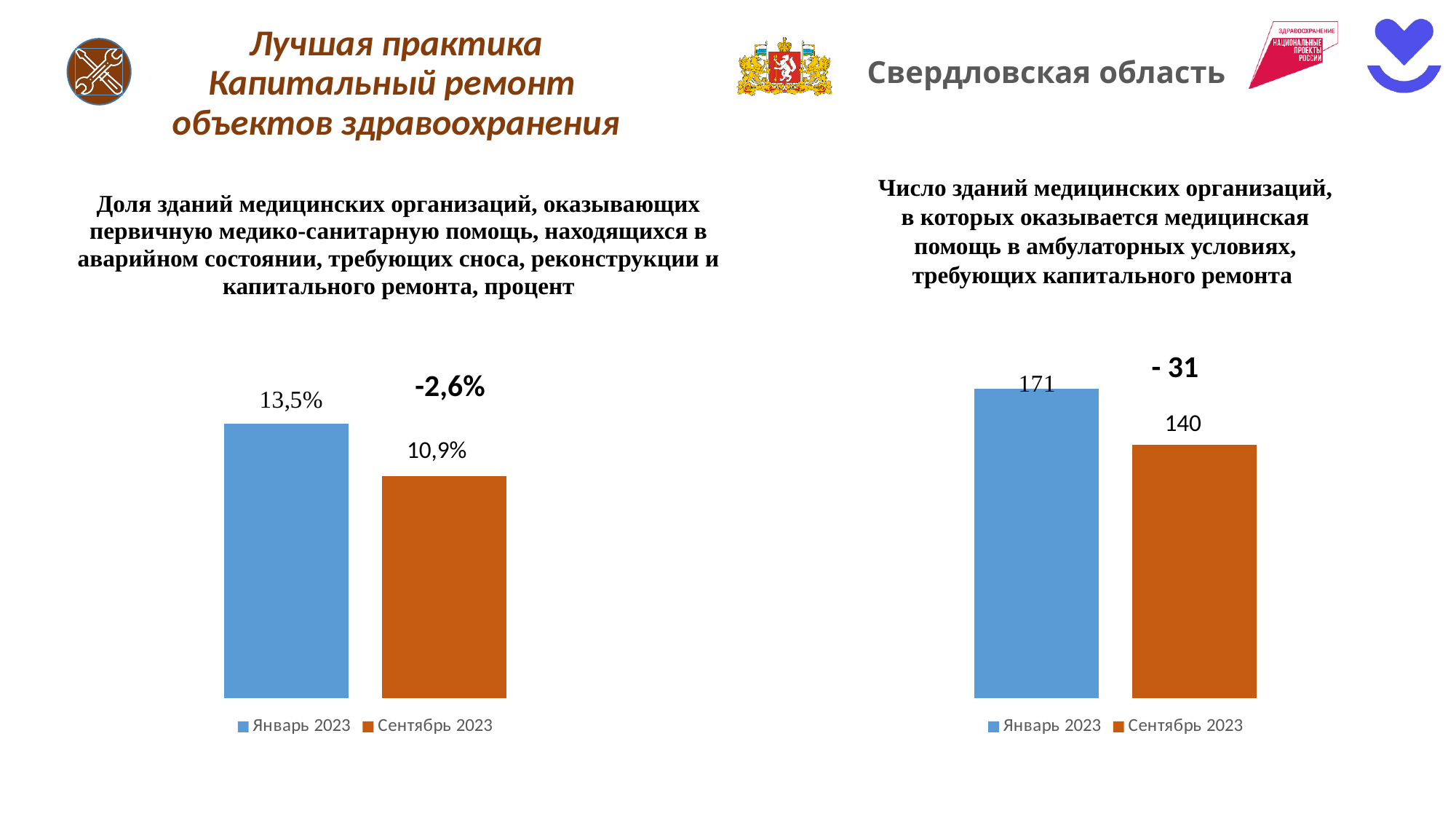
In the right chart, do the values rise or fall from Январь 2023 to Сентябрь 2023? Fall How many series does the legend of the right chart list? 2 In the left chart, which series has the higher value, Январь 2023 or Сентябрь 2023? Январь 2023 What type of chart is the left chart? Bar chart In the right chart, what is the difference between the Январь 2023 and Сентябрь 2023 values? 31 In the left chart, what colour is the bar for Сентябрь 2023? Orange In the right chart (number of buildings requiring capital repair), what is the value for Январь 2023? 171 In the left chart (share of buildings in emergency condition), what is the value for Январь 2023? 13,5% In the right chart, which series has the lower value? Сентябрь 2023 In the right chart (number of buildings requiring capital repair), what is the value for Сентябрь 2023? 140 In the left chart, by how much did the share fall from Январь 2023 to Сентябрь 2023? 2,6% In the left chart (share of buildings in emergency condition), what is the value for Сентябрь 2023? 10,9%